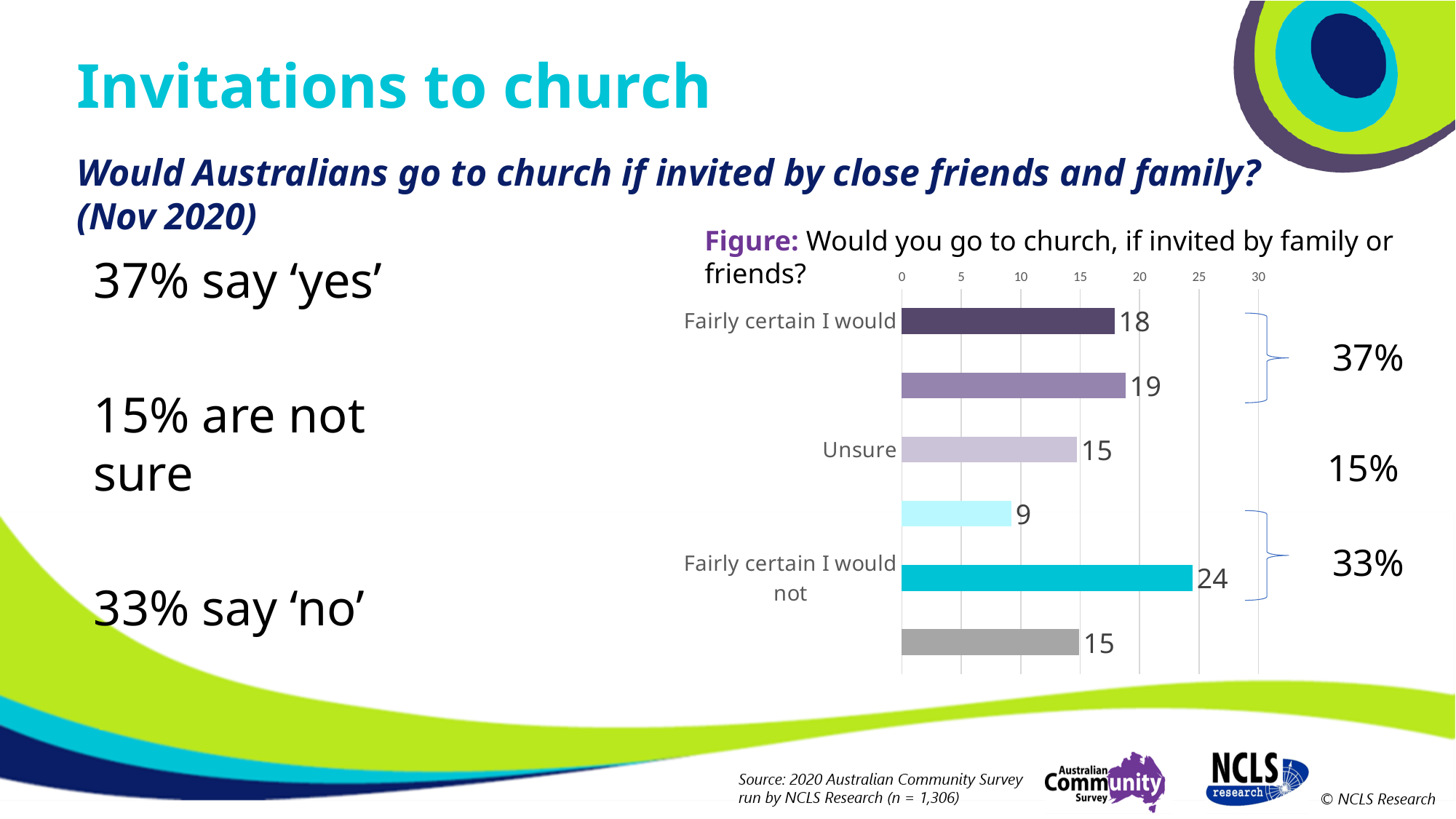
What value is shown for 'Fairly certain I would not'? 24 What kind of chart is shown on the slide? bar chart How many bars are plotted in the chart? 6 What combined percentage is shown beside the bracket grouping the top two bars? 37% Is the value for 'Fairly certain I would not' greater or less than 20? greater What is the difference between the values for 'Fairly certain I would not' and 'Fairly certain I would'? 6 What value is shown for 'Unsure'? 15 What is the smallest value labelled on any bar in the chart? 9 What combined percentage is shown beside the bracket grouping the bottom two bars? 33% Which is larger, the value for 'Fairly certain I would' or the value for 'Unsure'? Fairly certain I would Which labelled category has the highest value in the chart? Fairly certain I would not What value is shown for 'Fairly certain I would'? 18